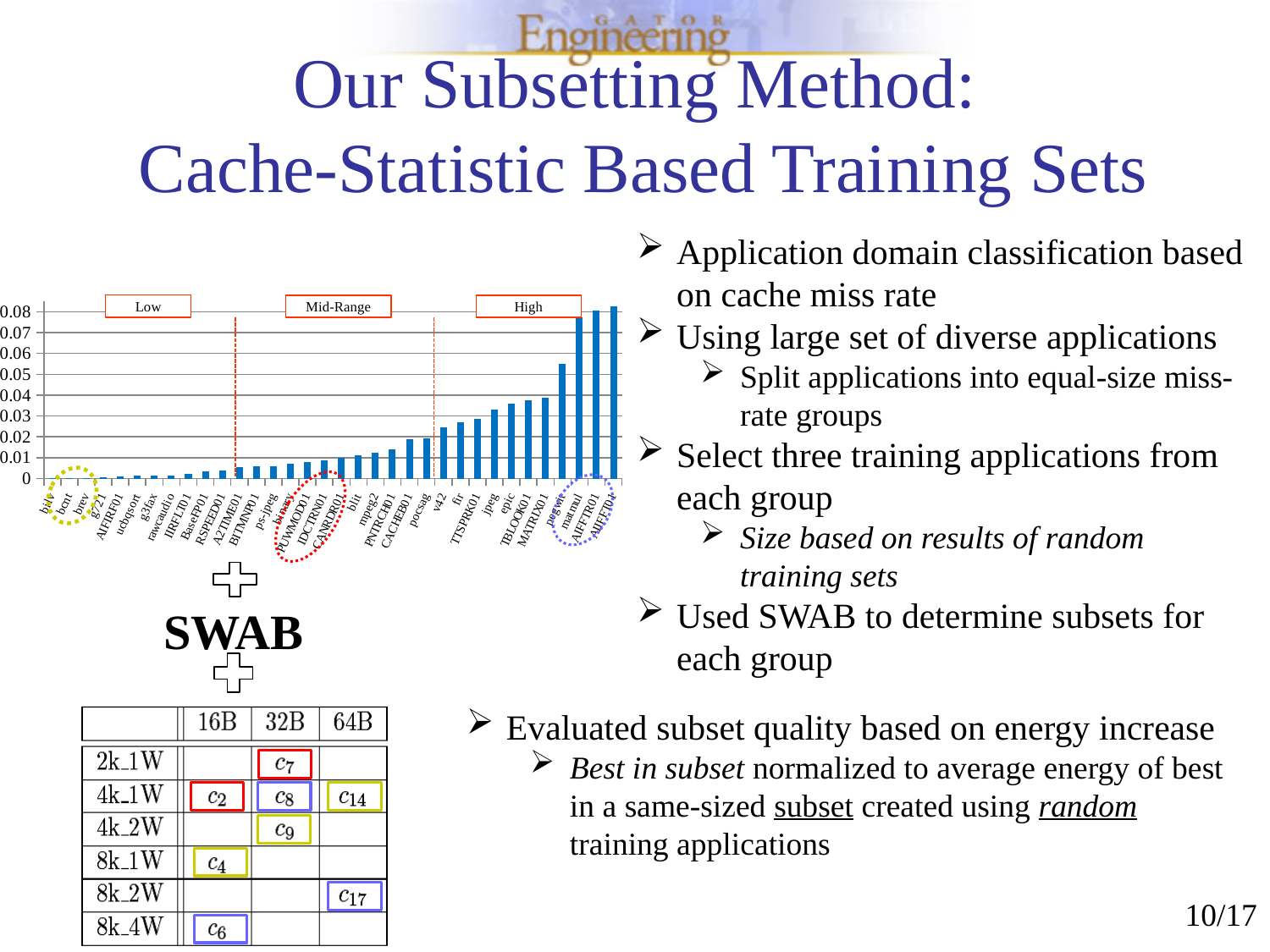
What are the three group labels shown above the bar chart? Low, Mid-Range, High Is the value for TBLOOK01 greater or less than 0.03? greater Is the value for matmul greater or less than 0.06? greater Which has the larger value, v42 or matmul? matmul What kind of chart is shown on the left of the slide? bar chart Which has the larger value, bcnt or epic? epic Do the bar values rise or fall from left to right along the x axis? rise Is the value for fir greater or less than 0.02? greater How many miss-rate groups is the bar chart divided into? 3